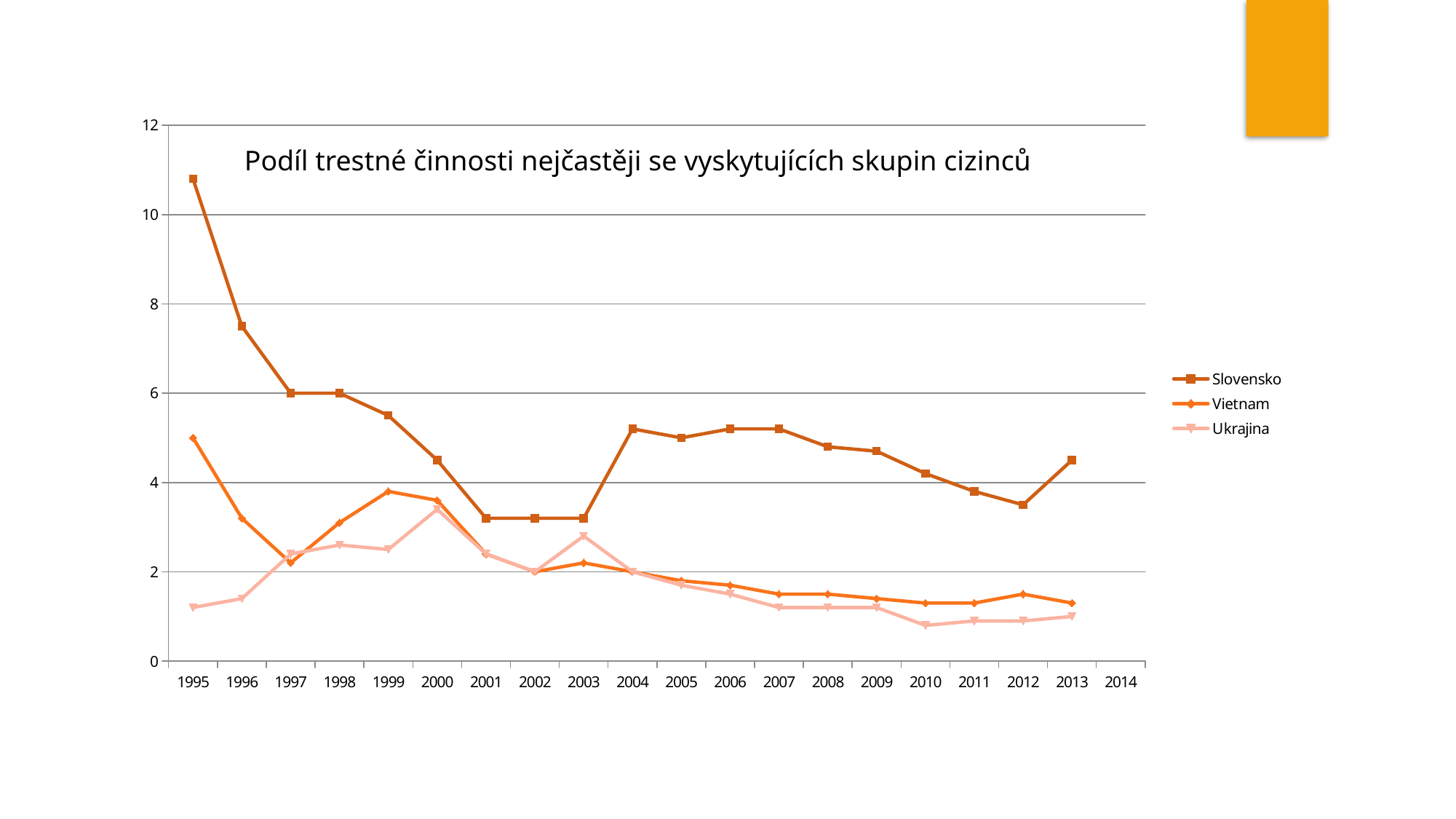
What kind of chart is shown on the slide? line chart Which series has the higher value in 1995, Slovensko or Vietnam? Slovensko Is the value for Slovensko in 2001 greater or less than 4? less Does the value for Slovensko rise or fall from 1995 to 2001? fall Which series has the higher value in 2003, Vietnam or Ukrajina? Ukrajina Is the value for Vietnam in 1995 greater or less than 4? greater How many years are labelled on the x axis? 20 In which year is the value for Slovensko highest? 1995 In which year is the value for Ukrajina highest? 2000 Is the value for Slovensko in 1995 greater or less than 10? greater What is the title of the chart? Podíl trestné činnosti nejčastěji se vyskytujících skupin cizinců How many series does the legend list? 3